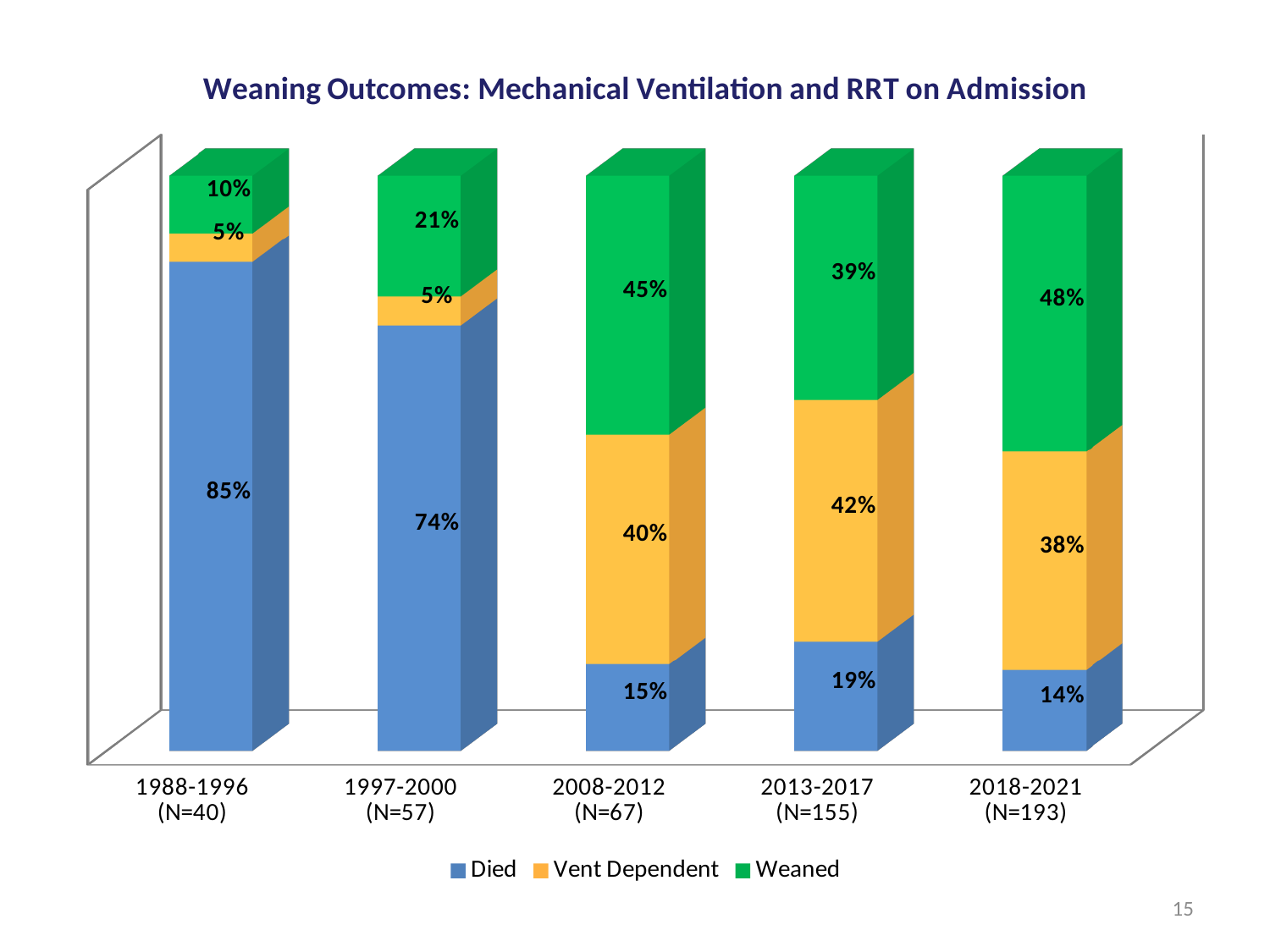
Which period has the lowest Weaned percentage? 1988-1996 (N=40) Is the Vent Dependent percentage larger in 2008-2012 or in 2018-2021? 2008-2012 Which colour represents the Weaned series in the legend? Green What percentage of patients died in the 1988-1996 (N=40) period? 85% Does the Died percentage generally rise or fall across the periods from 1988-1996 to 2018-2021? Fall How many time periods are shown on the x axis? 5 Which period has the highest Died percentage? 1988-1996 (N=40) How many series does the legend list? 3 What is the Weaned percentage for the 2018-2021 (N=193) period? 48% What kind of chart is shown on the slide? Stacked bar chart What is the Vent Dependent percentage for 2013-2017 (N=155)? 42% What is the difference between the Weaned percentage in 2018-2021 and in 1997-2000? 27%